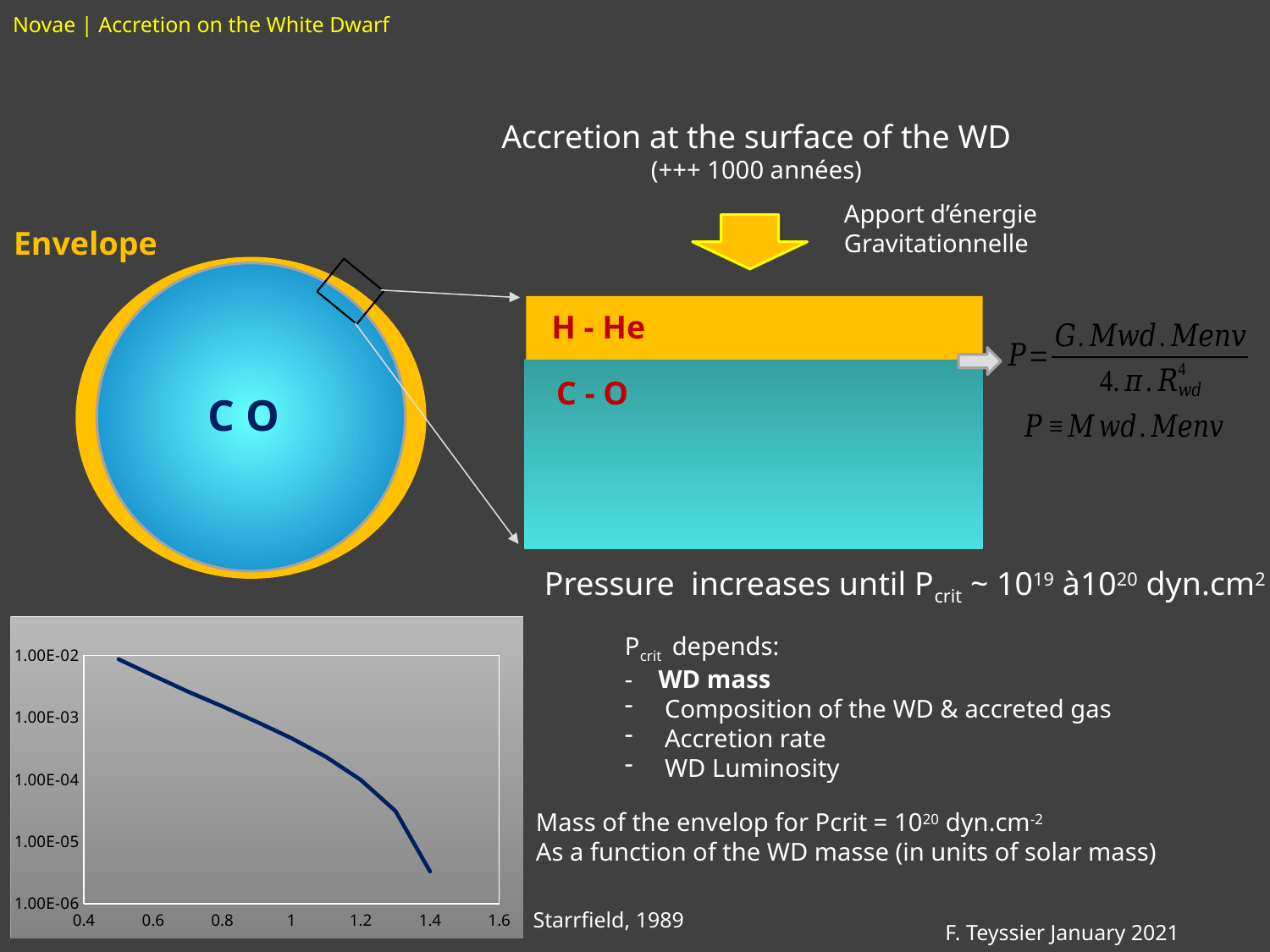
In the chart at the bottom left, is the plotted value at x = 1.2 greater or less than 1.00E-03? less In the chart at the bottom left, is the plotted value larger at x = 0.6 or at x = 1.2? 0.6 In the chart at the bottom left, does the plotted value rise or fall as the x-axis value increases from 0.4 to 1.6? fall In the chart at the bottom left, is the plotted value at x = 1.0 greater or less than 1.00E-04? greater In the chart at the bottom left, is the plotted value at x = 0.6 greater or less than 1.00E-03? greater What kind of chart is shown at the bottom left of the slide? line chart What is the largest value labeled on the x-axis of the chart at the bottom left? 1.6 What is the highest value labeled on the y-axis of the chart at the bottom left? 1.00E-02 How many lines are plotted in the chart at the bottom left? 1